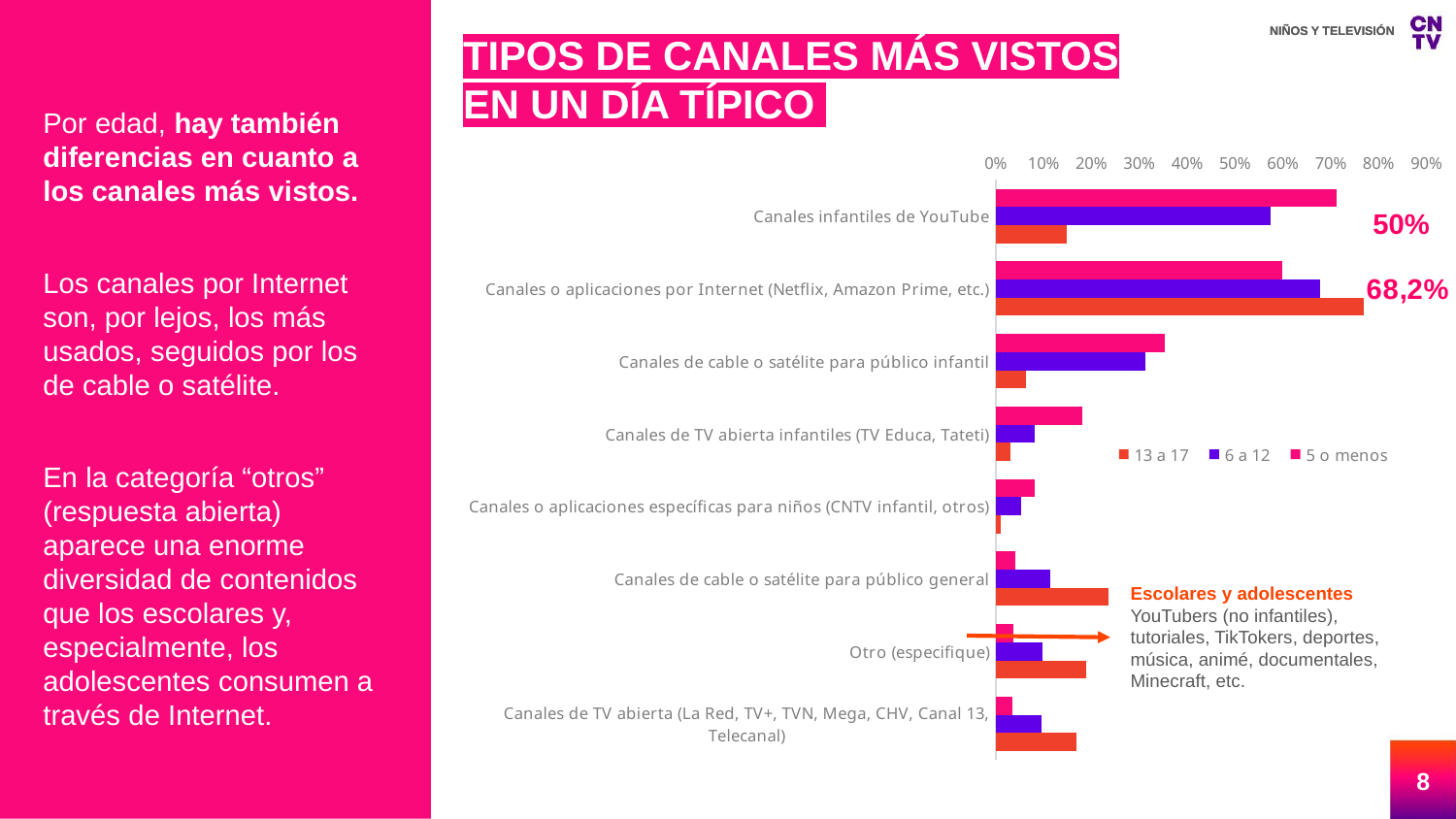
How many channel-type categories are plotted in the chart? 8 For 'Canales o aplicaciones por Internet', which age group has the largest value? 13 a 17 Is the '13 a 17' value for 'Canales de TV abierta infantiles (TV Educa, Tateti)' greater or less than 10%? less Which category has the highest value for the '13 a 17' series? Canales o aplicaciones por Internet (Netflix, Amazon Prime, etc.) Which category has the highest value for the '5 o menos' series? Canales infantiles de YouTube What kind of chart is shown on the slide? Bar chart For 'Canales infantiles de YouTube', which age group has the smallest value? 13 a 17 What is the title of the chart on the slide? TIPOS DE CANALES MÁS VISTOS EN UN DÍA TÍPICO For 'Canales de cable o satélite para público general', which is larger: the value for '13 a 17' or for '5 o menos'? 13 a 17 How many series does the chart legend list? 3 Is the '5 o menos' value for 'Canales infantiles de YouTube' greater or less than 60%? greater